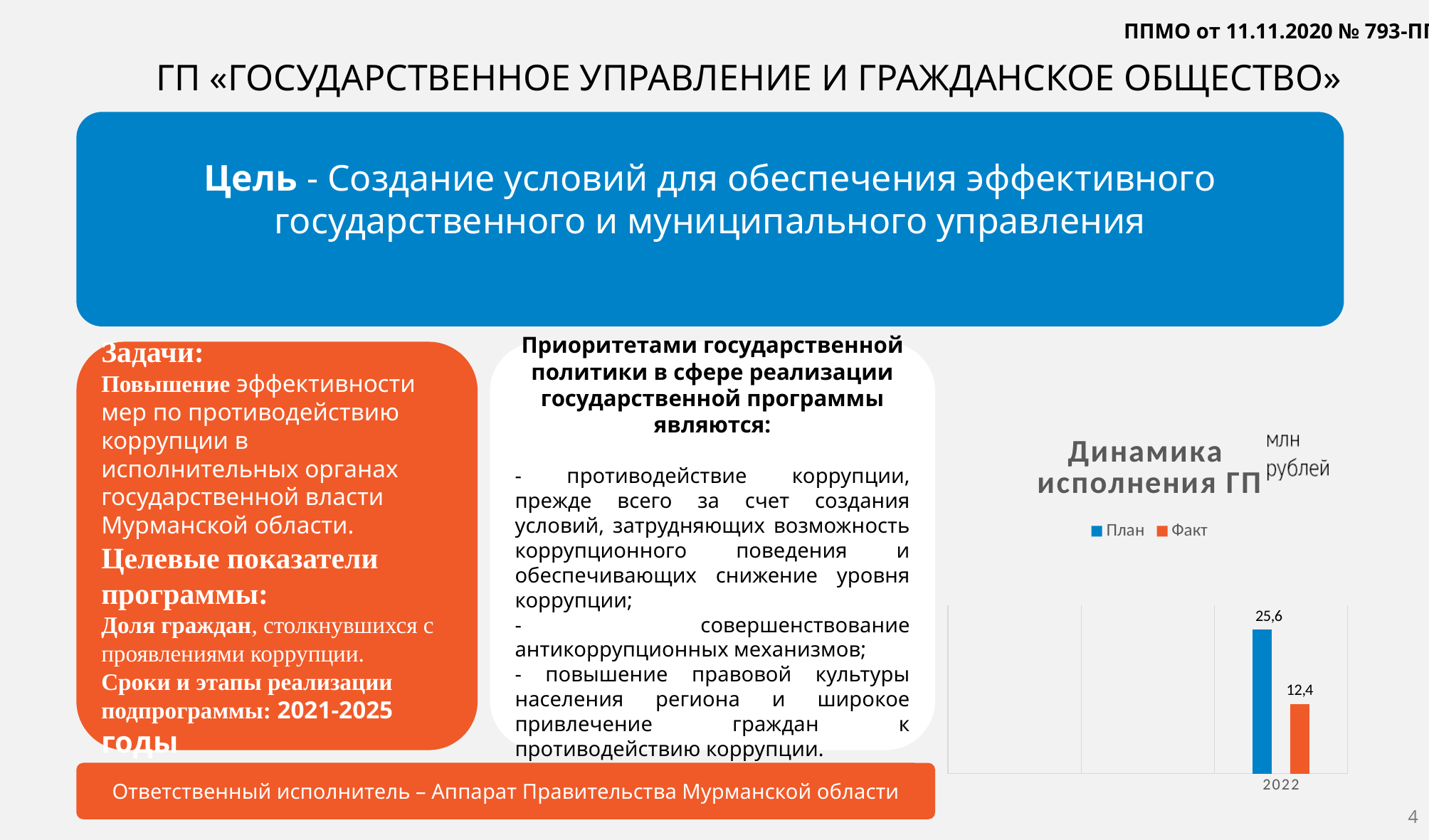
How many series does the chart legend list? 2 Which series has the higher value for 2022, План or Факт? План What is the title of the chart? Динамика исполнения ГП How many categories are shown on the x axis of the chart? 1 What is the value of План for 2022 in the chart? 25,6 Which year is shown on the x axis of the chart? 2022 Which series has the lowest value in the chart? Факт What is the difference between План and Факт for 2022? 13,2 What kind of chart is shown on the slide? bar chart What unit is indicated next to the chart title? млн рублей Which series has the highest value in the chart? План What is the value of Факт for 2022 in the chart? 12,4